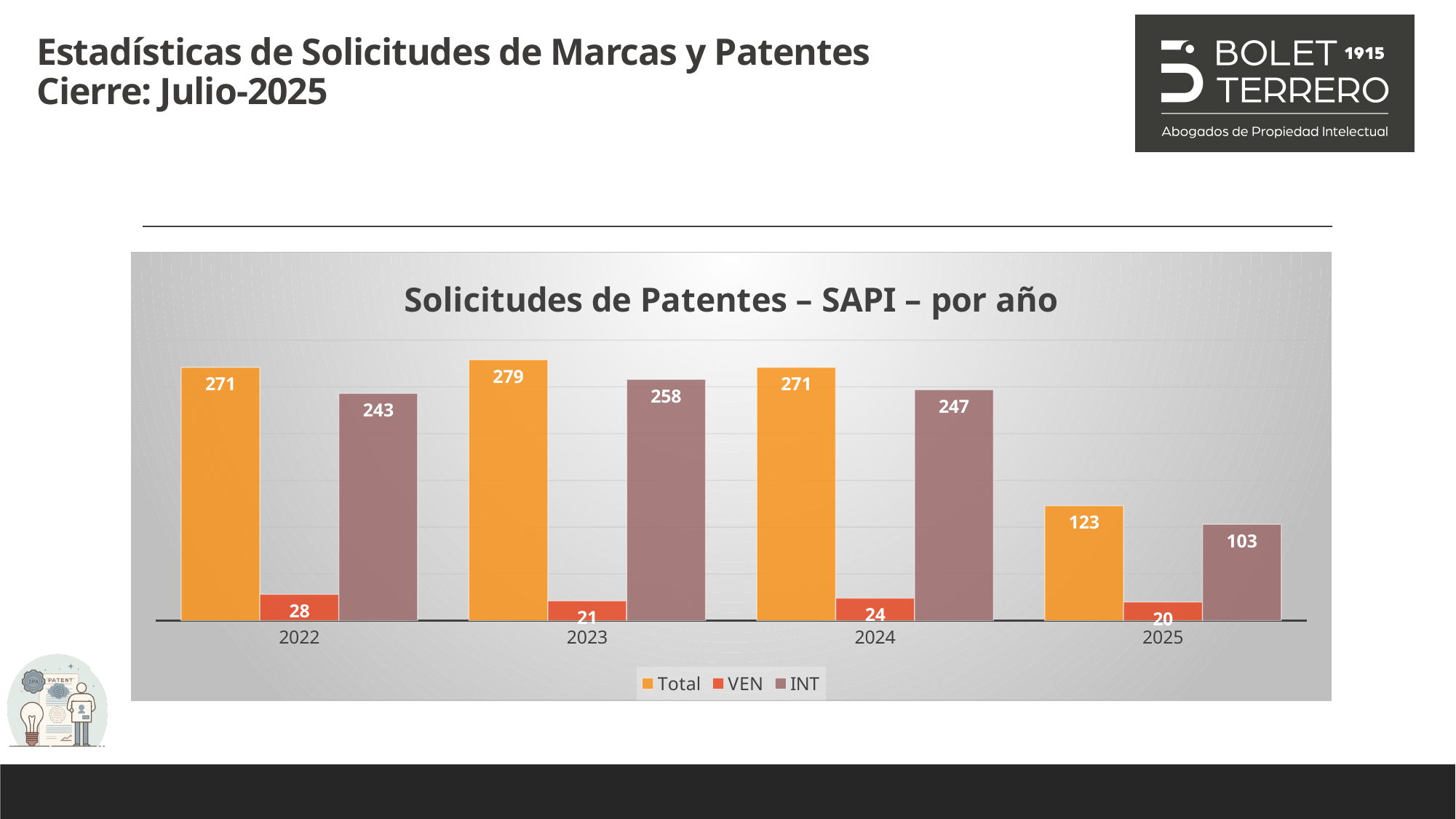
What is the difference between the Total values for 2024 and 2025? 148 What is the title of the chart? Solicitudes de Patentes – SAPI – por año What is the Total value for 2023? 279 What is the VEN value for 2022? 28 What kind of chart is shown? Bar chart What is the INT value for 2025? 103 Which is larger, the VEN value for 2022 or the VEN value for 2024? 2022 Does the INT value rise or fall from 2023 to 2025? Fall How many years are shown on the x axis? 4 Which year has the highest Total value? 2023 How many series does the legend list? 3 Which year has the lowest INT value? 2025